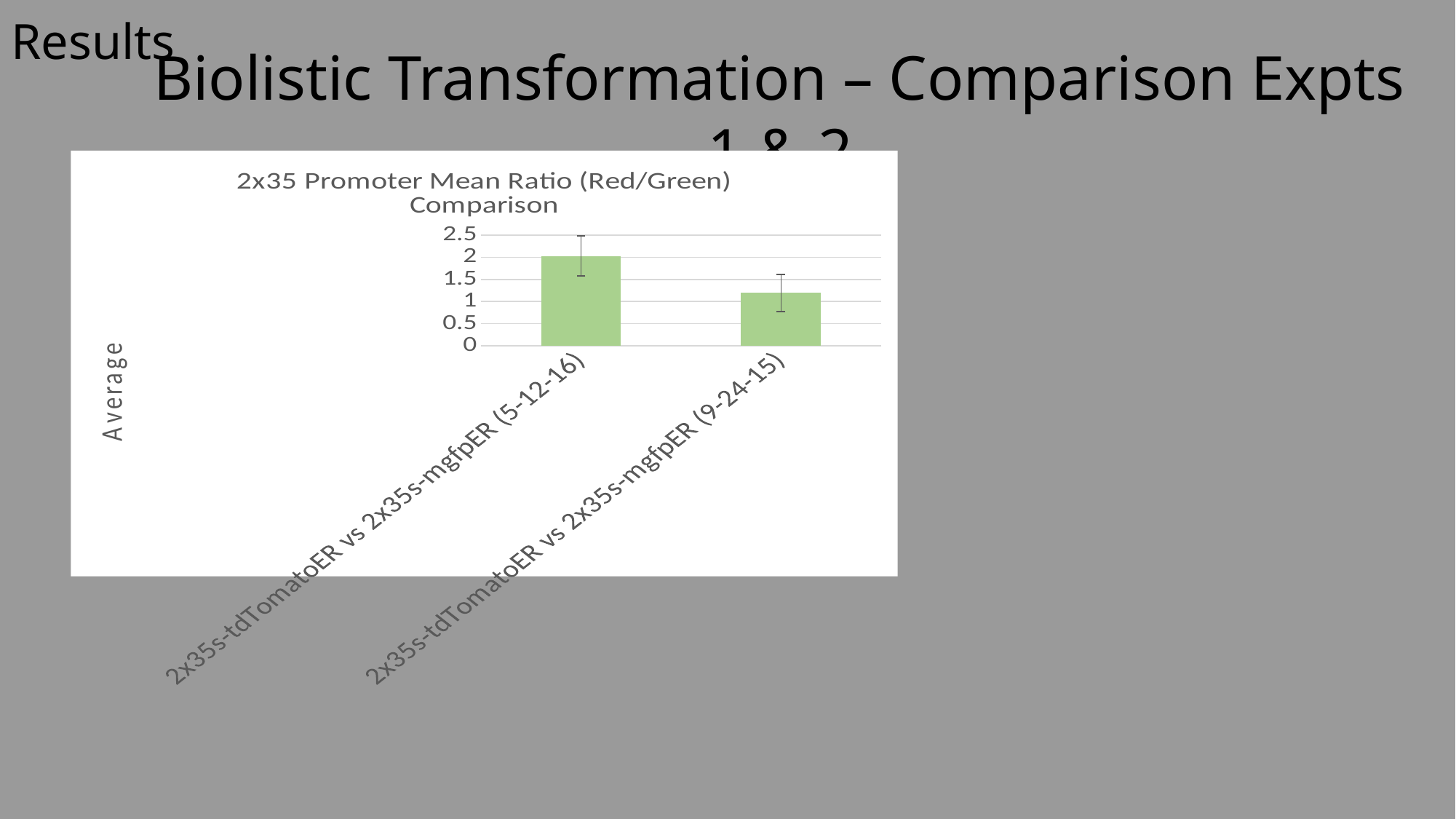
Is the value for 2x35s-tdTomatoER vs 2x35s-mgfpER (9-24-15) greater or less than 1? greater What kind of chart is shown on the slide? bar chart How many categories (bars) are plotted in the chart? 2 Which category has the highest value in the chart? 2x35s-tdTomatoER vs 2x35s-mgfpER (5-12-16) What is the title of the chart? 2x35 Promoter Mean Ratio (Red/Green) Comparison What is the label on the vertical axis of the chart? Average Which category has the lowest value in the chart? 2x35s-tdTomatoER vs 2x35s-mgfpER (9-24-15) Is the value for 2x35s-tdTomatoER vs 2x35s-mgfpER (5-12-16) greater or less than 1.5? greater Which is larger: the value for 2x35s-tdTomatoER vs 2x35s-mgfpER (5-12-16) or the value for 2x35s-tdTomatoER vs 2x35s-mgfpER (9-24-15)? 2x35s-tdTomatoER vs 2x35s-mgfpER (5-12-16) Do the values rise or fall from the first bar to the second bar along the x axis? fall Is the value for 2x35s-tdTomatoER vs 2x35s-mgfpER (9-24-15) greater or less than 1.5? less